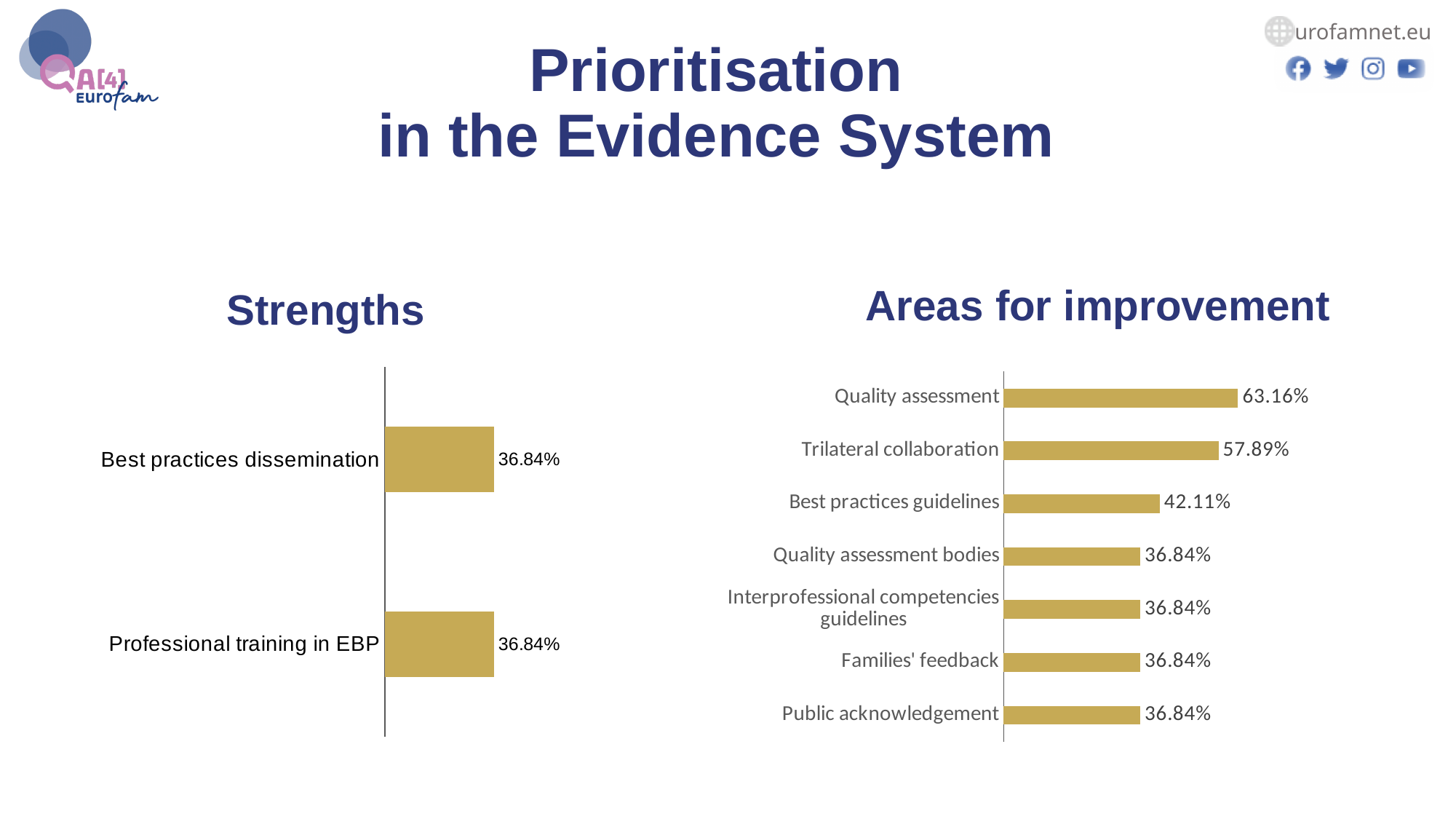
In the Strengths chart, what is the value for Professional training in EBP? 36.84% How many categories are shown in the Areas for improvement chart? 7 In the Areas for improvement chart, what is the value for Trilateral collaboration? 57.89% In the Areas for improvement chart, how many categories have a value of 36.84%? 4 What kind of chart is the Strengths chart? Bar chart In the Areas for improvement chart, what is the difference between Quality assessment and Trilateral collaboration? 5.27% How many categories are shown in the Strengths chart? 2 In the Areas for improvement chart, what is the difference between Best practices guidelines and Families' feedback? 5.27% In the Areas for improvement chart, what is the value for Quality assessment? 63.16% In the Areas for improvement chart, which is larger: Trilateral collaboration or Best practices guidelines? Trilateral collaboration In the Areas for improvement chart, what is the value for Best practices guidelines? 42.11% In the Areas for improvement chart, which category has the highest value? Quality assessment